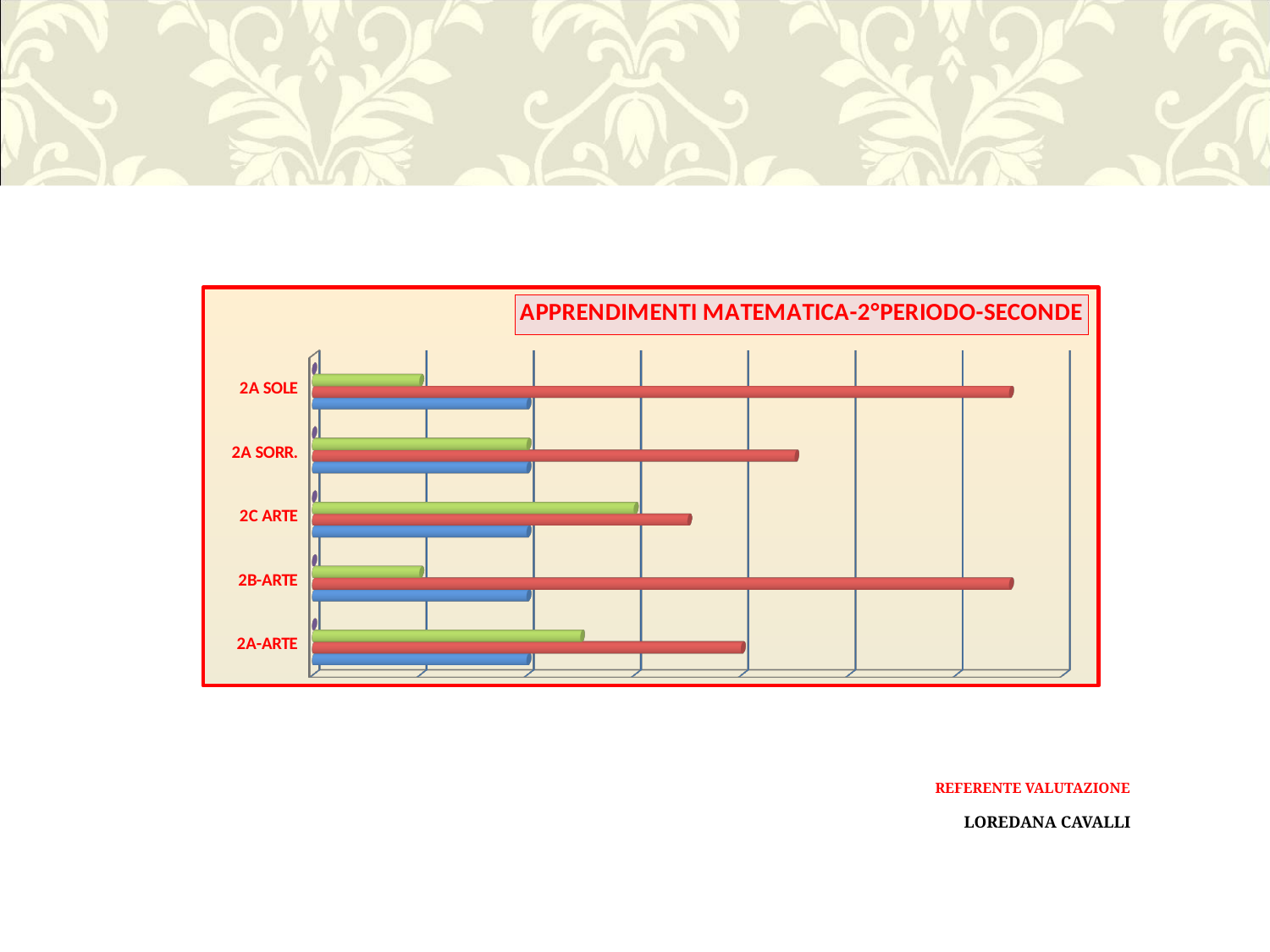
Which class has the longer red bar, 2A SORR. or 2A-ARTE? 2A SORR. Which class has the shortest red bar in the chart? 2C ARTE How many categories (classes) are shown on the vertical axis of the chart? 5 Which class has the longer green bar, 2C ARTE or 2A-ARTE? 2C ARTE Which class has the longest green bar in the chart? 2C ARTE What is the title of the chart? APPRENDIMENTI MATEMATICA-2°PERIODO-SECONDE Which class has the longer green bar, 2A SORR. or 2B-ARTE? 2A SORR. What kind of chart is shown on the slide? bar chart How many bars are plotted for each class in the chart? 3 Which class is listed at the top of the vertical axis of the chart? 2A SOLE What colours are the three bars shown for each class in the chart? green, red and blue